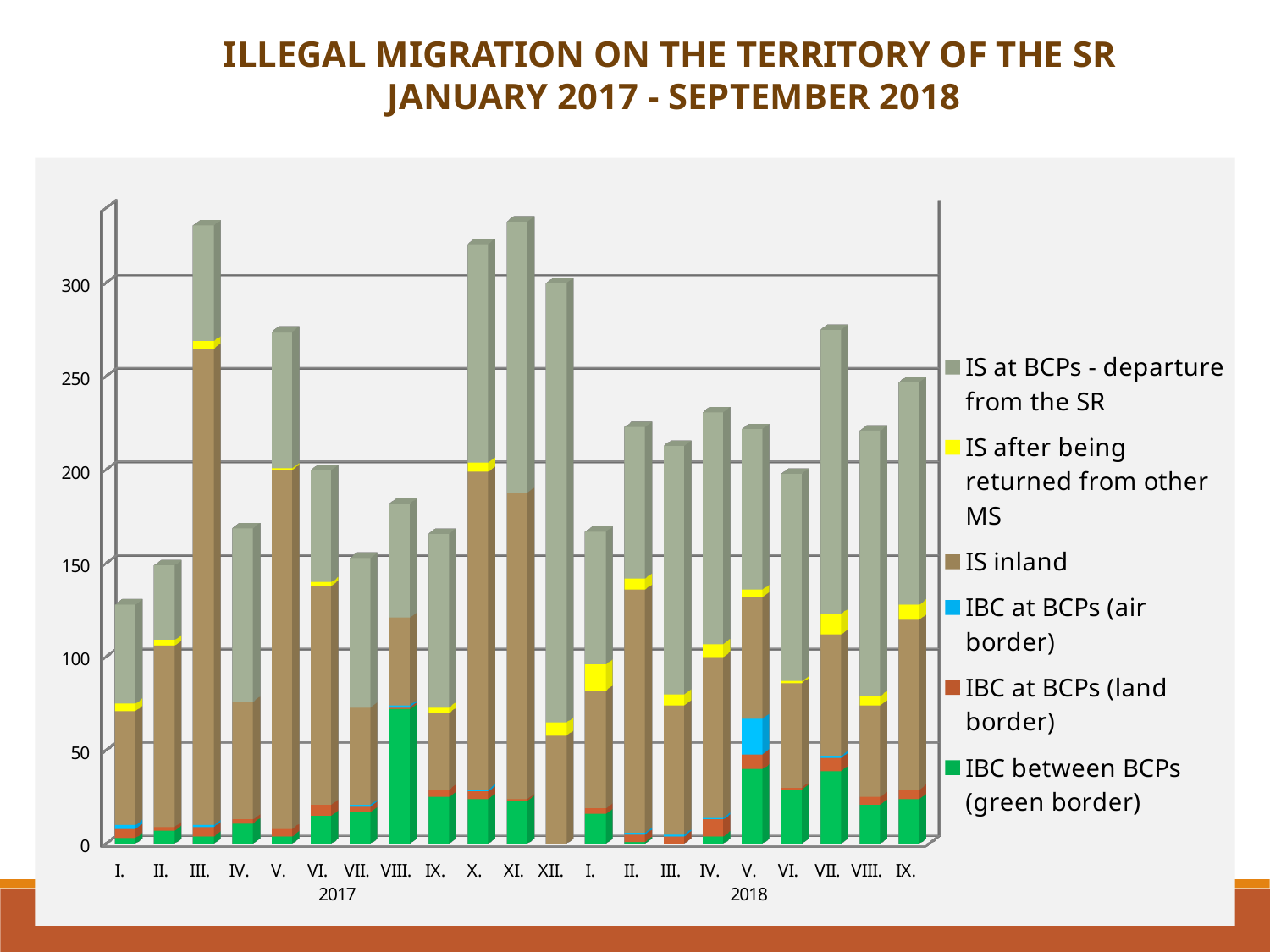
Is the total for VII. 2018 greater or less than 250? greater Which series is shown in blue in the legend? IBC at BCPs (air border) How many months of 2018 are plotted in the chart? 9 Is the total for I. 2017 greater or less than 150? less Between IX. 2017 and XI. 2017, do the total bars rise or fall? rise Which month has the lowest total bar in the chart? I. 2017 Which has the larger total bar, IX. 2017 or X. 2017? X. 2017 Is the total for III. 2017 greater or less than 300? greater What kind of chart is shown on the slide? Stacked bar chart How many series does the legend list? 6 How many monthly bars are plotted in the chart? 21